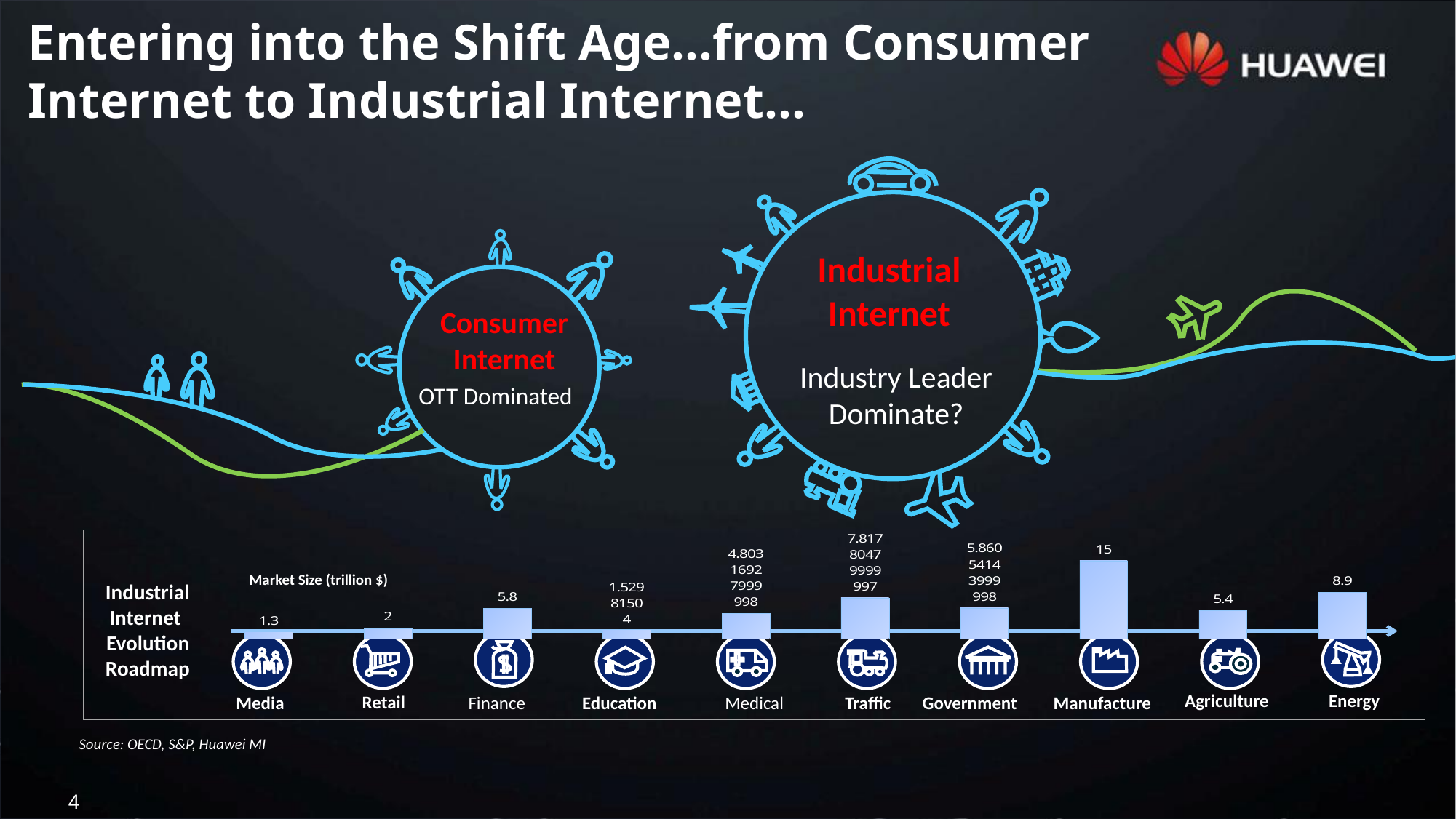
What is the market size value shown for Agriculture? 5.4 Which has a larger market size, Energy or Finance? Energy Which industry has the largest market size in the chart? Manufacture What is the market size value shown for Manufacture? 15 What is the market size value shown for Energy? 8.9 What is the market size value shown for Media? 1.3 How many industries are shown in the market size chart? 10 What unit is given in the title of the market size chart? trillion $ What is the market size value shown for Retail? 2 What is the difference between the market size values for Energy and Finance? 3.1 What kind of chart is used to show the market size by industry? Bar chart Which industry has the smallest market size in the chart? Media